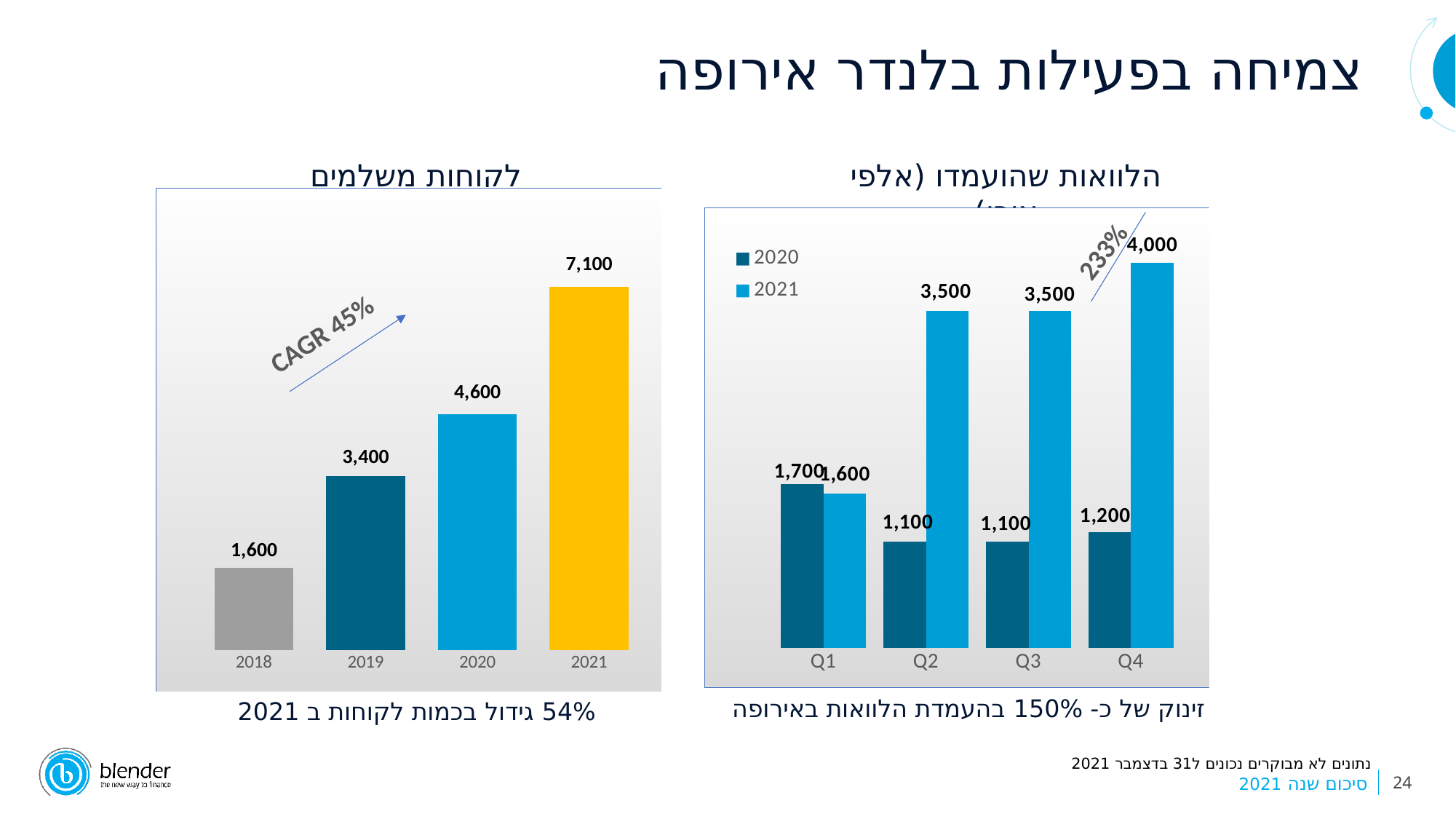
In the left chart (paying customers), do the values rise or fall from 2018 to 2021? rise In the left chart (paying customers), what is the difference between the 2021 and 2020 values? 2,500 In the left chart (paying customers), which year has the highest value? 2021 In the right chart (loans granted), what is the 2021 value for Q4? 4,000 In the left chart (paying customers), how many years are shown on the x axis? 4 In the right chart (loans granted), what is the difference between the 2021 and 2020 values for Q2? 2,400 In the right chart (loans granted), what is the 2020 value for Q1? 1,700 In the left chart (paying customers), what is the value for 2021? 7,100 In the left chart (paying customers), what is the value for 2018? 1,600 What kind of chart is the right chart (loans granted)? bar chart In the right chart (loans granted), which is larger for Q1: the 2020 value or the 2021 value? 2020 In the right chart (loans granted), how many series does the legend list? 2